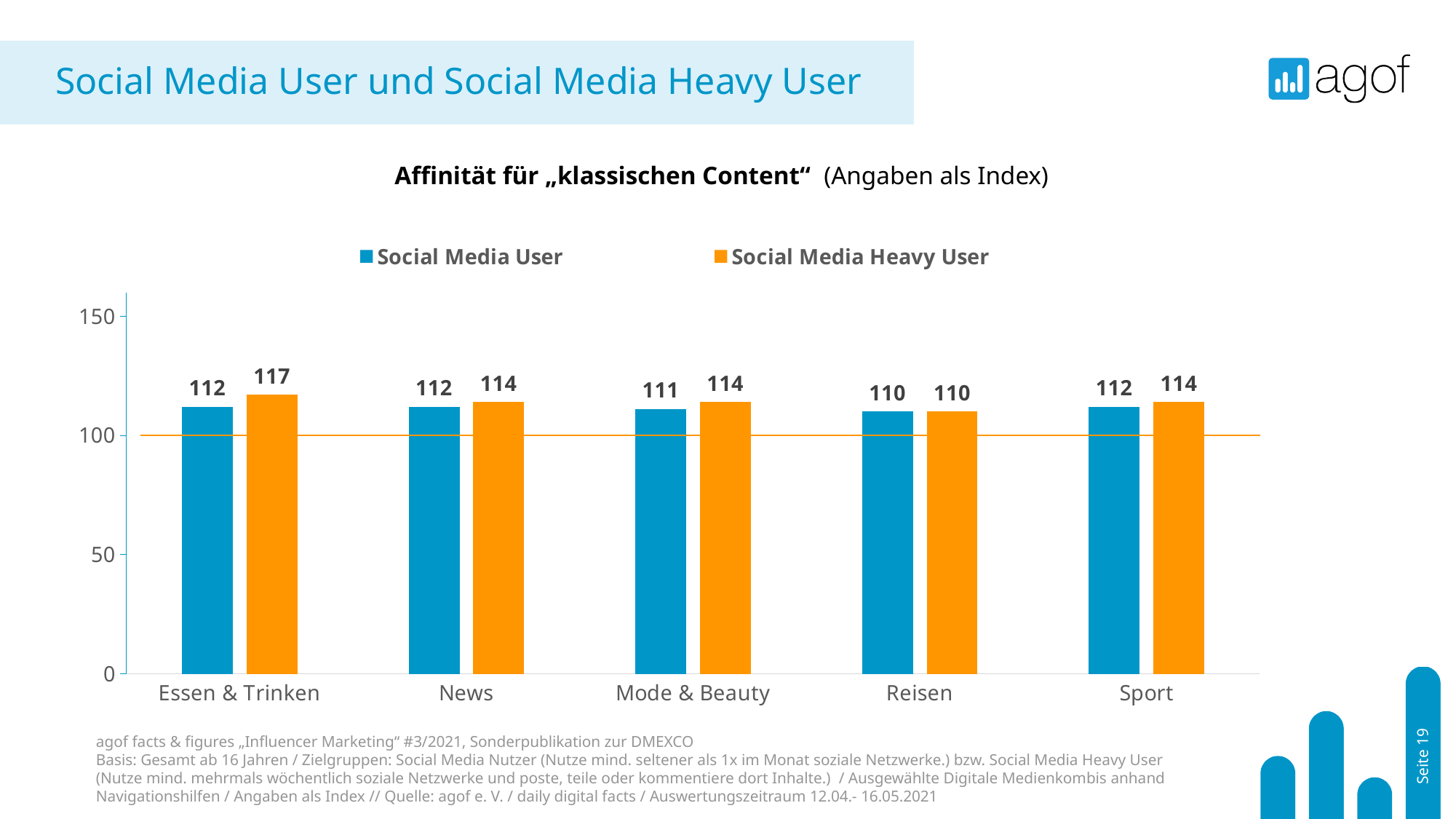
What is the Social Media User index value for Essen & Trinken? 112 Which is larger for News: the Social Media User value or the Social Media Heavy User value? Social Media Heavy User What is the difference between the Social Media Heavy User and Social Media User values for Essen & Trinken? 5 How many categories are shown on the x axis? 5 Which category has the highest Social Media Heavy User value? Essen & Trinken What is the Social Media Heavy User index value for Reisen? 110 Which category has the lowest Social Media User value? Reisen How many series does the legend list? 2 What is the Social Media Heavy User index value for Essen & Trinken? 117 What kind of chart is shown on the slide? Bar chart What is the Social Media User index value for Mode & Beauty? 111 What colour represents the Social Media Heavy User series? Orange